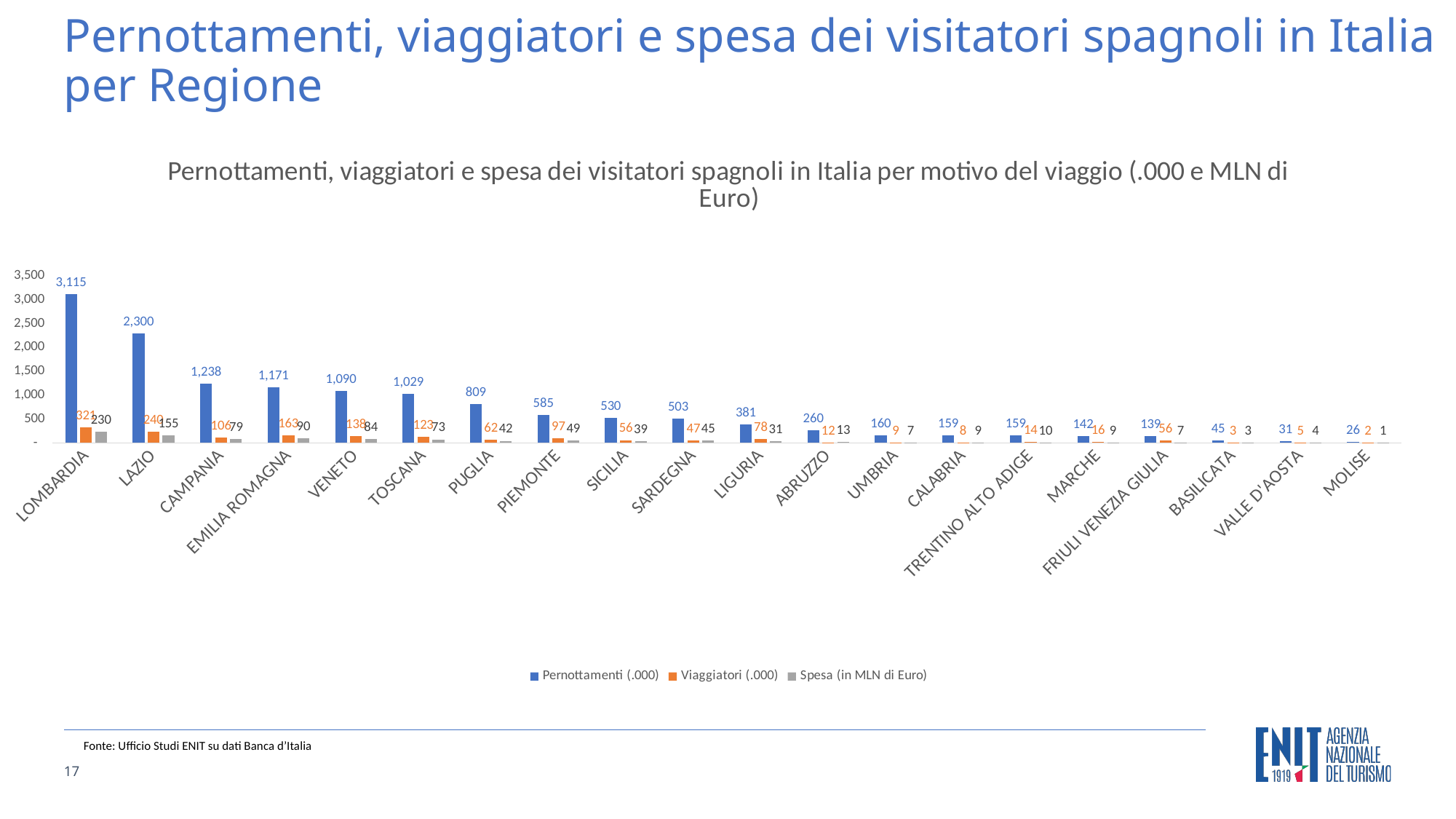
What is the Pernottamenti (.000) value for LOMBARDIA? 3,115 What is the Spesa (in MLN di Euro) value for EMILIA ROMAGNA? 90 How many regions are shown on the x axis of the chart? 20 Which is larger, the Viaggiatori (.000) value for CAMPANIA or for EMILIA ROMAGNA? EMILIA ROMAGNA What is the difference between the Pernottamenti (.000) values for LOMBARDIA and LAZIO? 815 Which region has the highest Pernottamenti (.000) value? LOMBARDIA Is the Pernottamenti (.000) value for PUGLIA greater or less than 1,000? less Which colour represents the Viaggiatori (.000) series in the chart? orange Which region has the lowest Spesa (in MLN di Euro) value? MOLISE What is the Viaggiatori (.000) value for LAZIO? 240 What kind of chart is shown on the slide? bar chart How many series does the legend list? 3